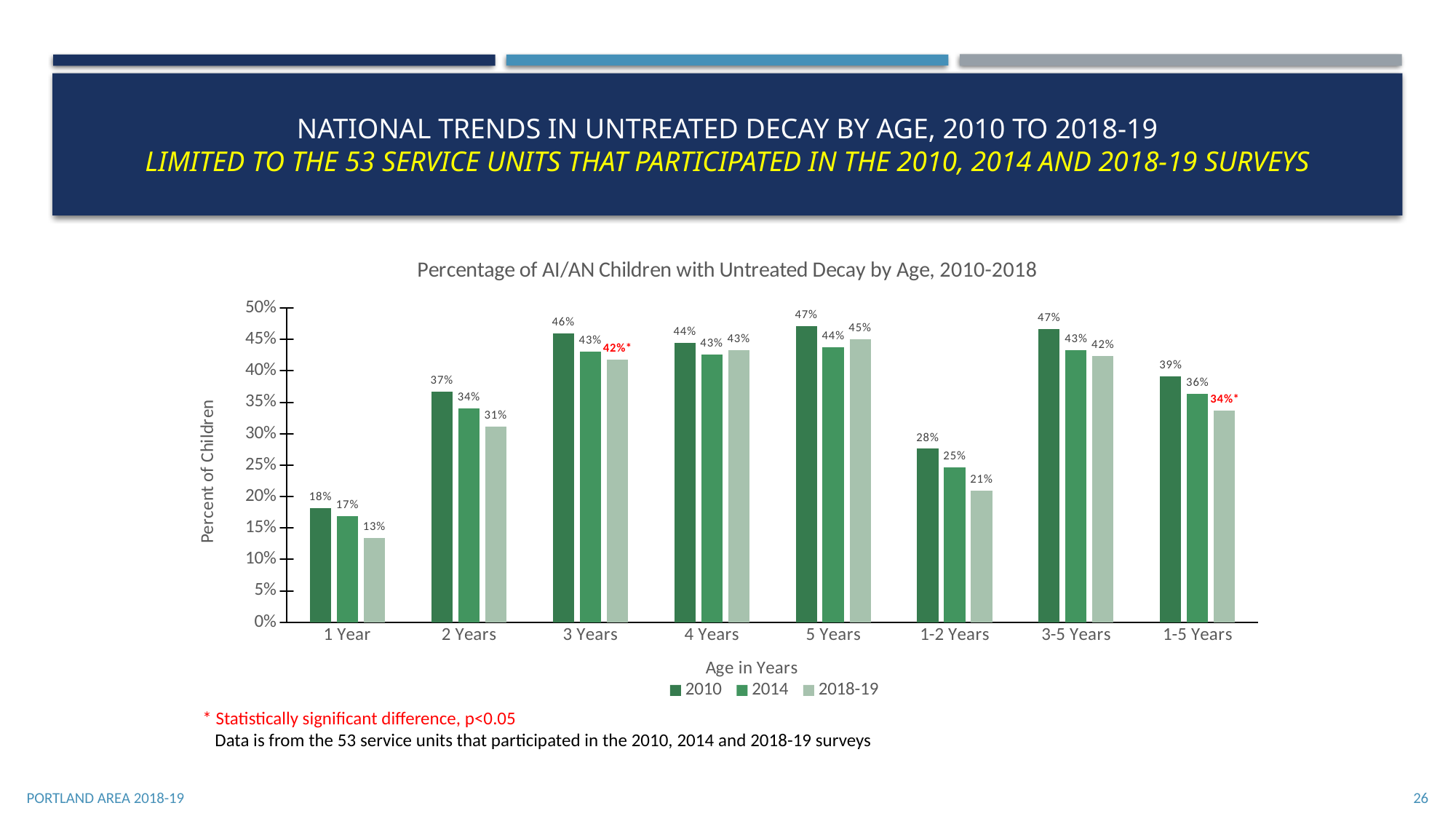
What is the value for 2018-19 in the 1-2 Years category? 21% Which age category has the lowest value for the 2018-19 series? 1 Year How many series does the legend list? 3 What is the value for 2010 in the 1 Year category? 18% How many age categories are shown on the x axis? 8 Do the values for the 1-5 Years category rise or fall from 2010 to 2018-19? Fall What is the label of the y axis? Percent of Children What kind of chart is shown on the slide? Bar chart Which age category has the highest value for the 2014 series? 5 Years What is the value for 2014 in the 1-5 Years category? 36% Which is larger, the 2010 value for 3 Years or the 2010 value for 4 Years? 3 Years What is the difference between the 2010 and 2018-19 values for the 2 Years category? 6%